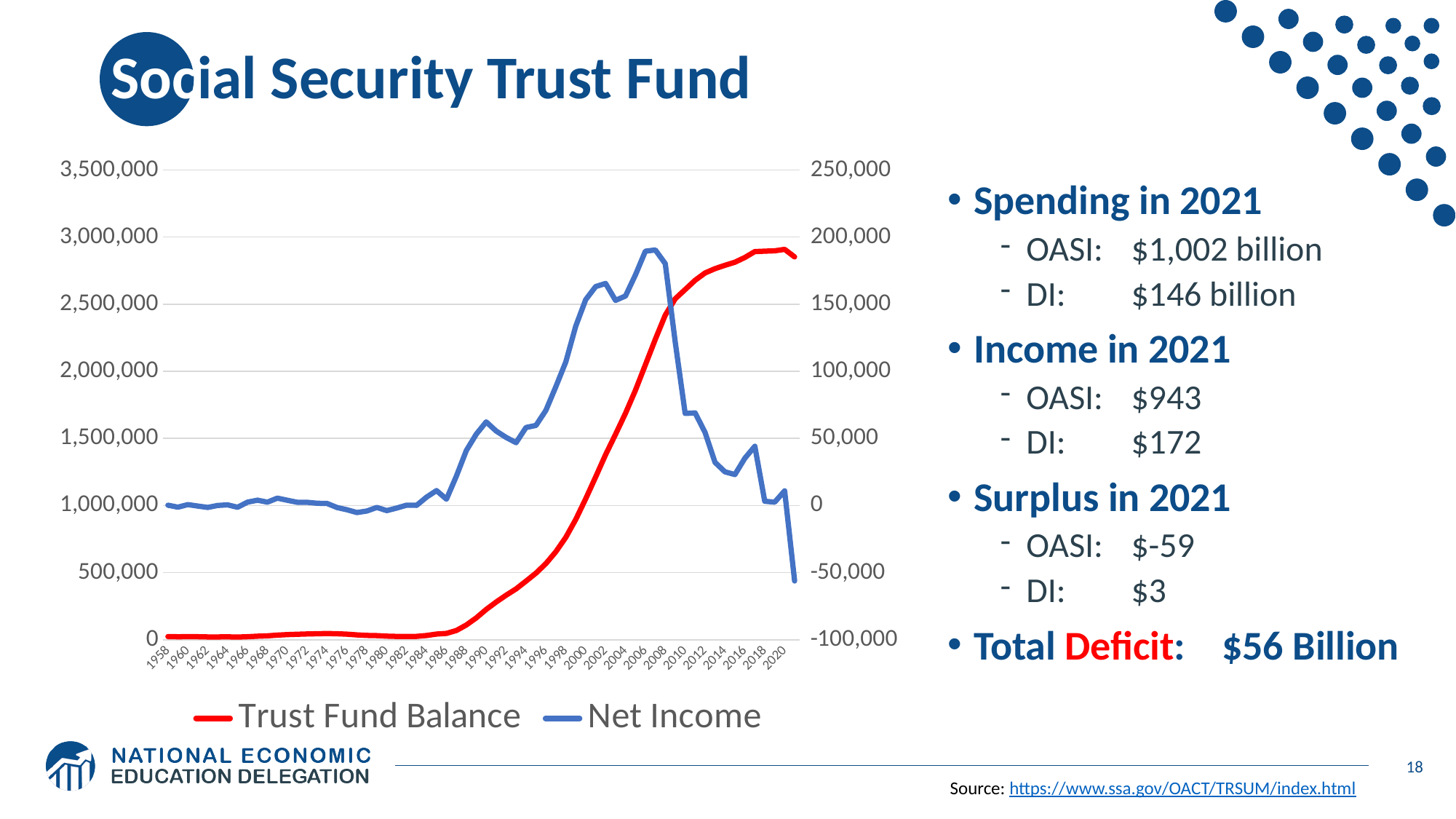
How many series does the chart legend list? 2 Is the Trust Fund Balance in 1990 greater or less than 500,000? less Which series is drawn in red on the chart? Trust Fund Balance Is Net Income in 2006 greater or less than 150,000? greater Is the Trust Fund Balance in 2020 greater or less than 2,500,000? greater What kind of chart is shown on the slide? line chart Does Net Income rise or fall from 2008 to 2020? fall Which is larger, Net Income in 2006 or Net Income in 2020? 2006 Which series is drawn in blue on the chart? Net Income Does the Trust Fund Balance rise or fall from 1958 to 2018? rise